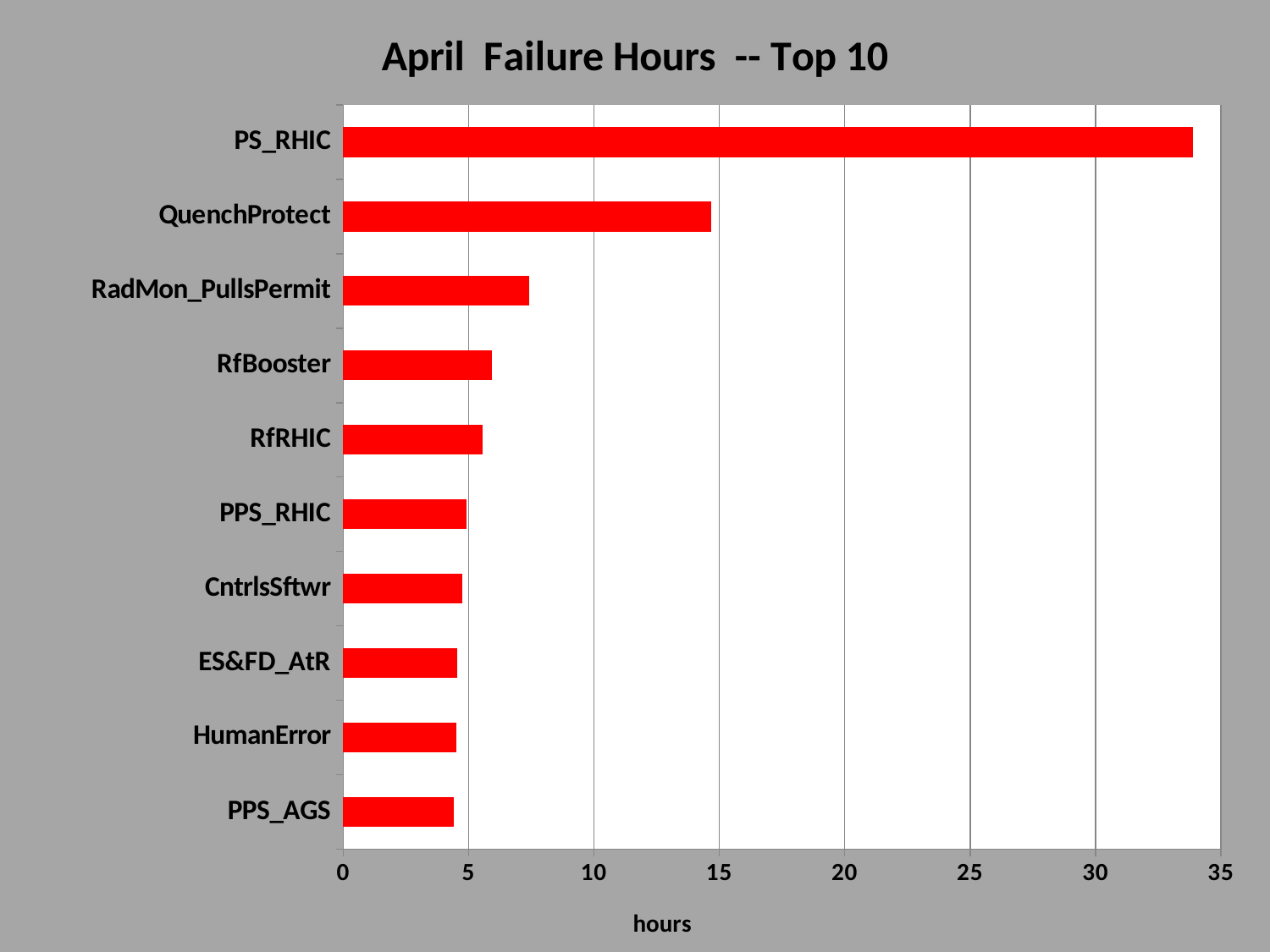
Is the value for QuenchProtect greater or less than 10? greater How many categories are plotted in the chart? 10 Is the value for PS_RHIC greater or less than 30? greater Is the value for RadMon_PullsPermit greater or less than 5? greater Which has more failure hours, QuenchProtect or RfRHIC? QuenchProtect Which category has the highest failure hours? PS_RHIC Which has more failure hours, RadMon_PullsPermit or RfBooster? RadMon_PullsPermit What is the title of the chart? April Failure Hours -- Top 10 What kind of chart is shown on the slide? bar chart Which has more failure hours, PS_RHIC or QuenchProtect? PS_RHIC What is the label on the horizontal axis of the chart? hours